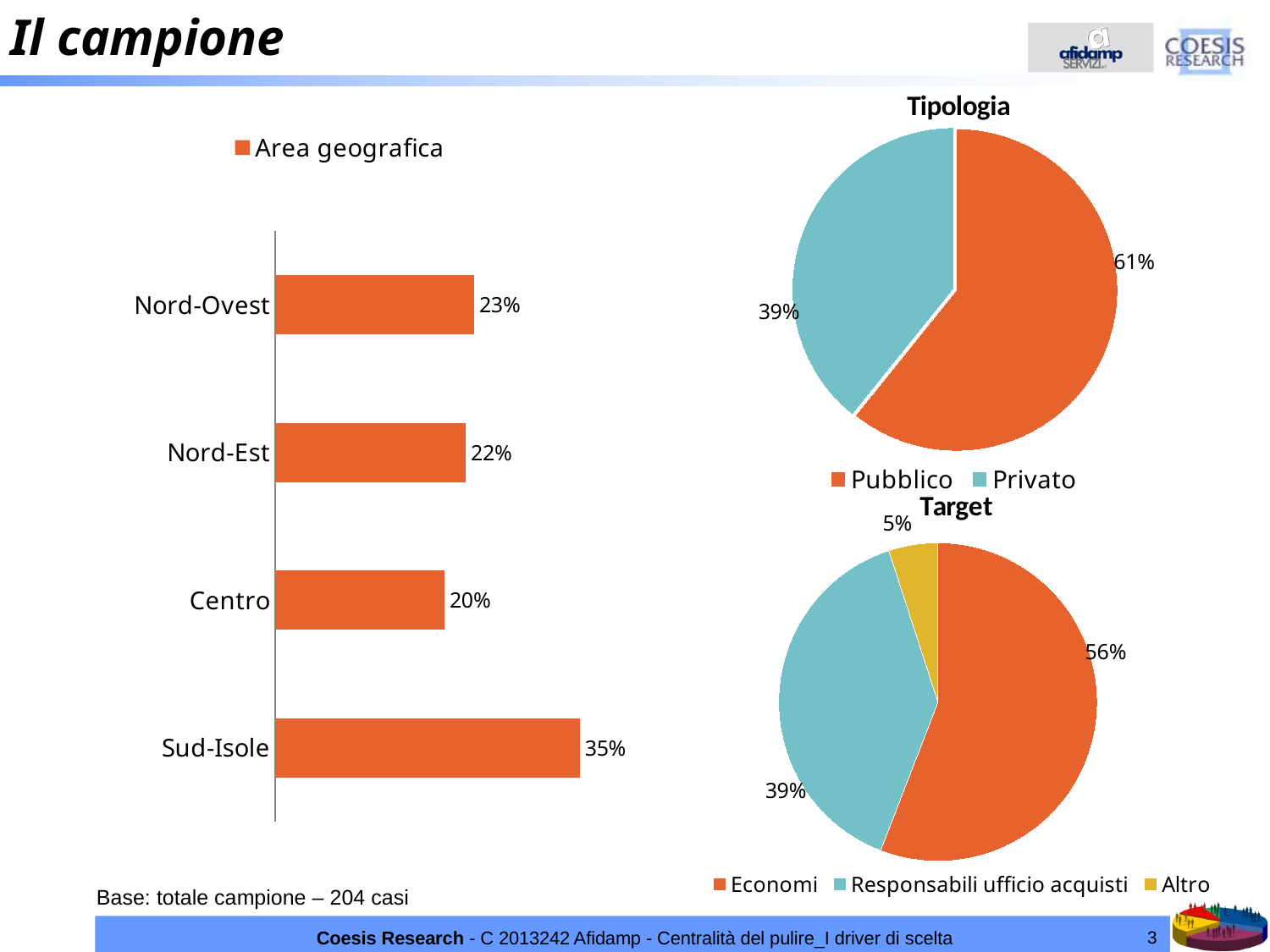
In the 'Tipologia' pie chart, what share does Pubblico have? 61% What kind of chart is the 'Area geografica' chart? Bar chart In the 'Tipologia' pie chart, which is larger, Pubblico or Privato? Pubblico In the 'Area geografica' bar chart, which category has the highest value? Sud-Isole In the 'Area geografica' bar chart, what is the value for Sud-Isole? 35% In the 'Target' pie chart, what is the difference between Economi and Responsabili ufficio acquisti? 17% In the 'Area geografica' bar chart, what is the difference between Sud-Isole and Centro? 15% In the 'Area geografica' bar chart, which category has the lowest value? Centro In the 'Target' pie chart, what share does Altro have? 5% In the 'Area geografica' bar chart, what is the value for Nord-Est? 22% How many entries does the legend of the 'Target' pie chart list? 3 In the 'Area geografica' bar chart, how many categories are shown? 4